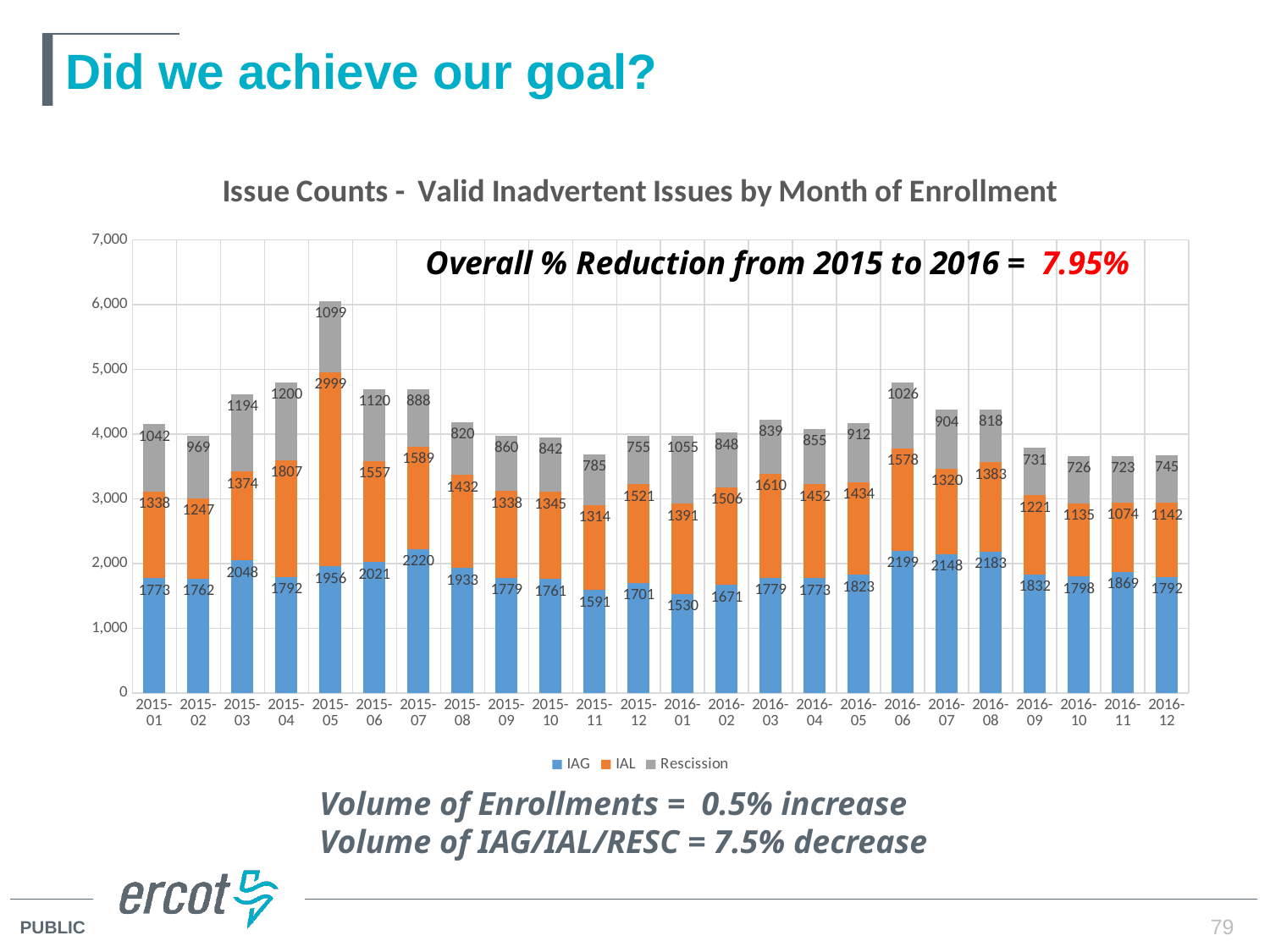
What is the total of the stacked bar for 2016-12? 3679 What is the difference between the IAL values for 2015-05 and 2015-04? 1192 What is the IAL value for 2015-05? 2999 Which month has the highest IAL value? 2015-05 How many months are shown on the x axis? 24 Which is larger, the IAG value for 2015-07 or the IAG value for 2016-08? 2015-07 Which month has the lowest IAG value? 2016-01 What is the IAG value for 2016-06? 2199 Is the total stacked bar for 2015-05 greater or less than 6,000? greater What is the Rescission value for 2016-12? 745 How many series does the legend list? 3 What kind of chart is shown? Stacked bar chart